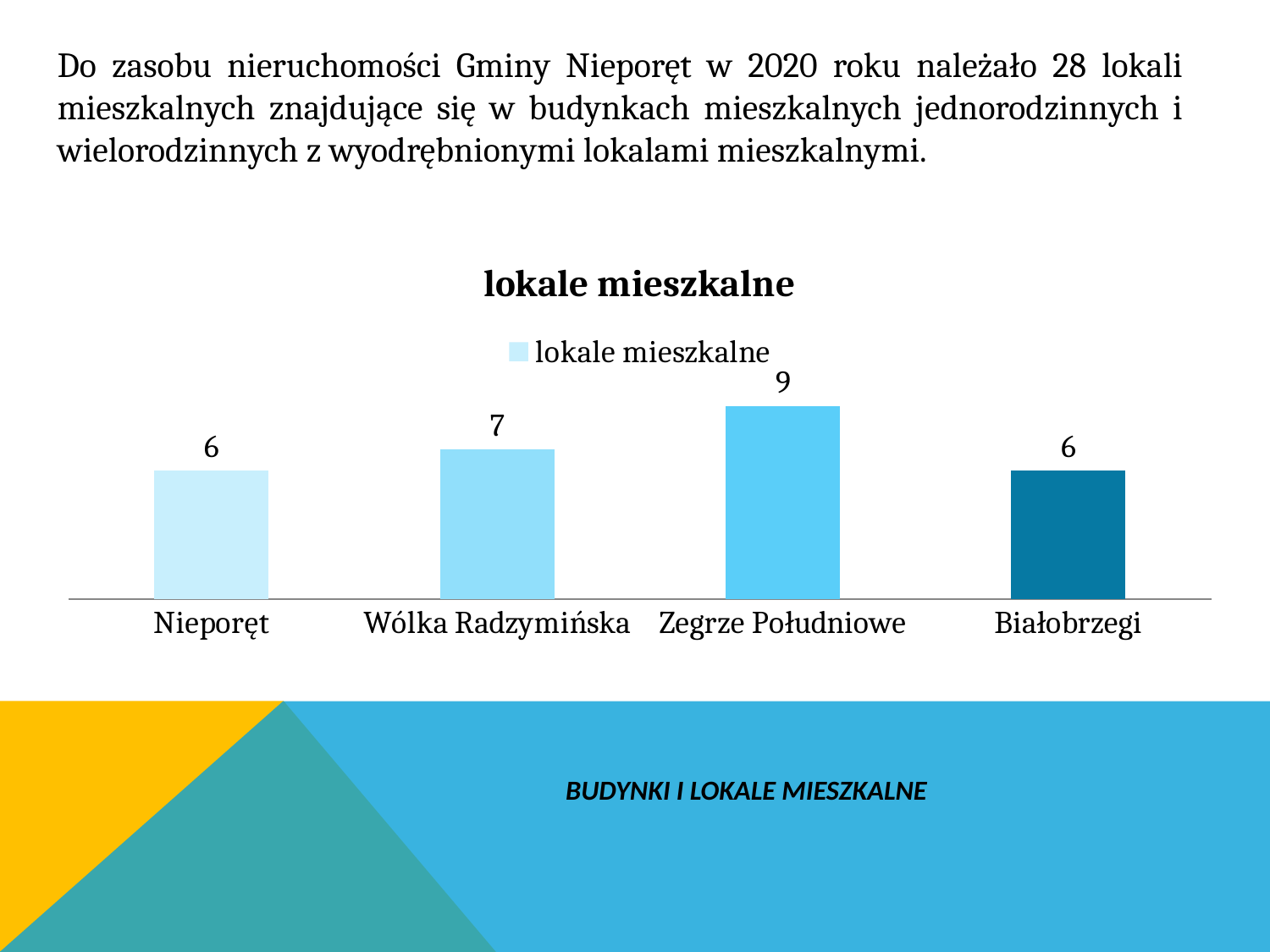
What is the value for Nieporęt? 6 What is the value for Wólka Radzymińska? 7 What is the value for Białobrzegi? 6 How many series does the legend list? 1 What is the title of the chart? lokale mieszkalne How many categories are shown on the x axis? 4 What is the value for Zegrze Południowe? 9 What is the difference between the values for Zegrze Południowe and Wólka Radzymińska? 2 What is the difference between the values for Zegrze Południowe and Nieporęt? 3 Which is larger, the value for Wólka Radzymińska or the value for Białobrzegi? Wólka Radzymińska Which category has the highest value? Zegrze Południowe What kind of chart is shown? bar chart